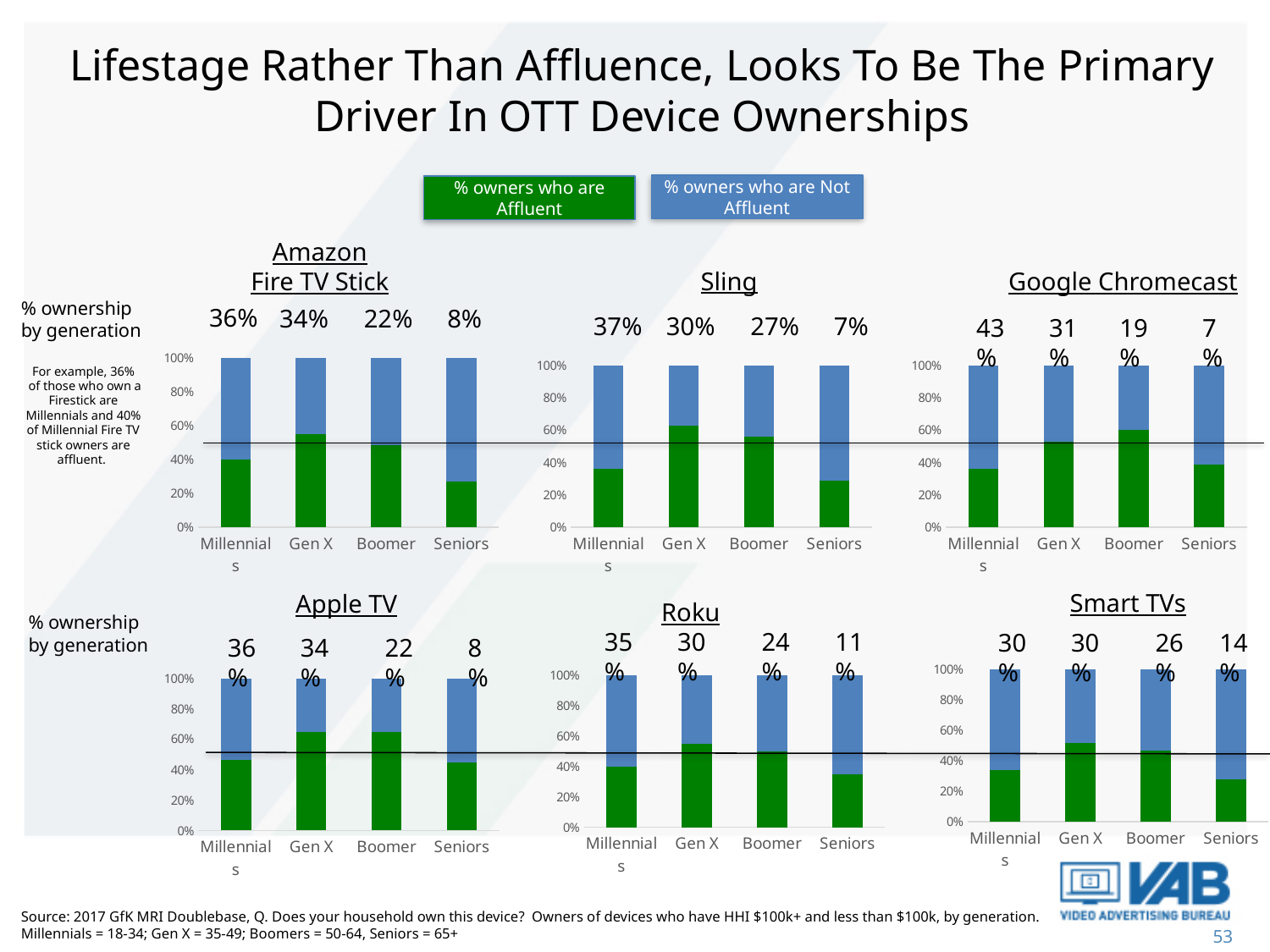
How many generation categories are shown on the x axis of the Sling chart? 4 In the Sling chart, which generation has the highest % owners who are Affluent? Gen X In the Amazon Fire TV Stick chart, which generation has the lowest % owners who are Affluent? Seniors In the Smart TVs chart, is the % owners who are Affluent value for Seniors greater or less than 60%? less In the Google Chromecast chart, which generation has the highest % owners who are Affluent? Boomer In the Roku chart, is the % owners who are Affluent value larger for Gen X or for Seniors? Gen X How many series does the legend list for the charts on this slide? 2 In the Amazon Fire TV Stick chart, which colour represents % owners who are Affluent? Green In the Sling chart, is the % owners who are Affluent value for Gen X greater or less than 40%? greater What kind of chart is the Amazon Fire TV Stick chart? Stacked bar chart In the Apple TV chart, is the % owners who are Affluent value for Boomer greater or less than 40%? greater